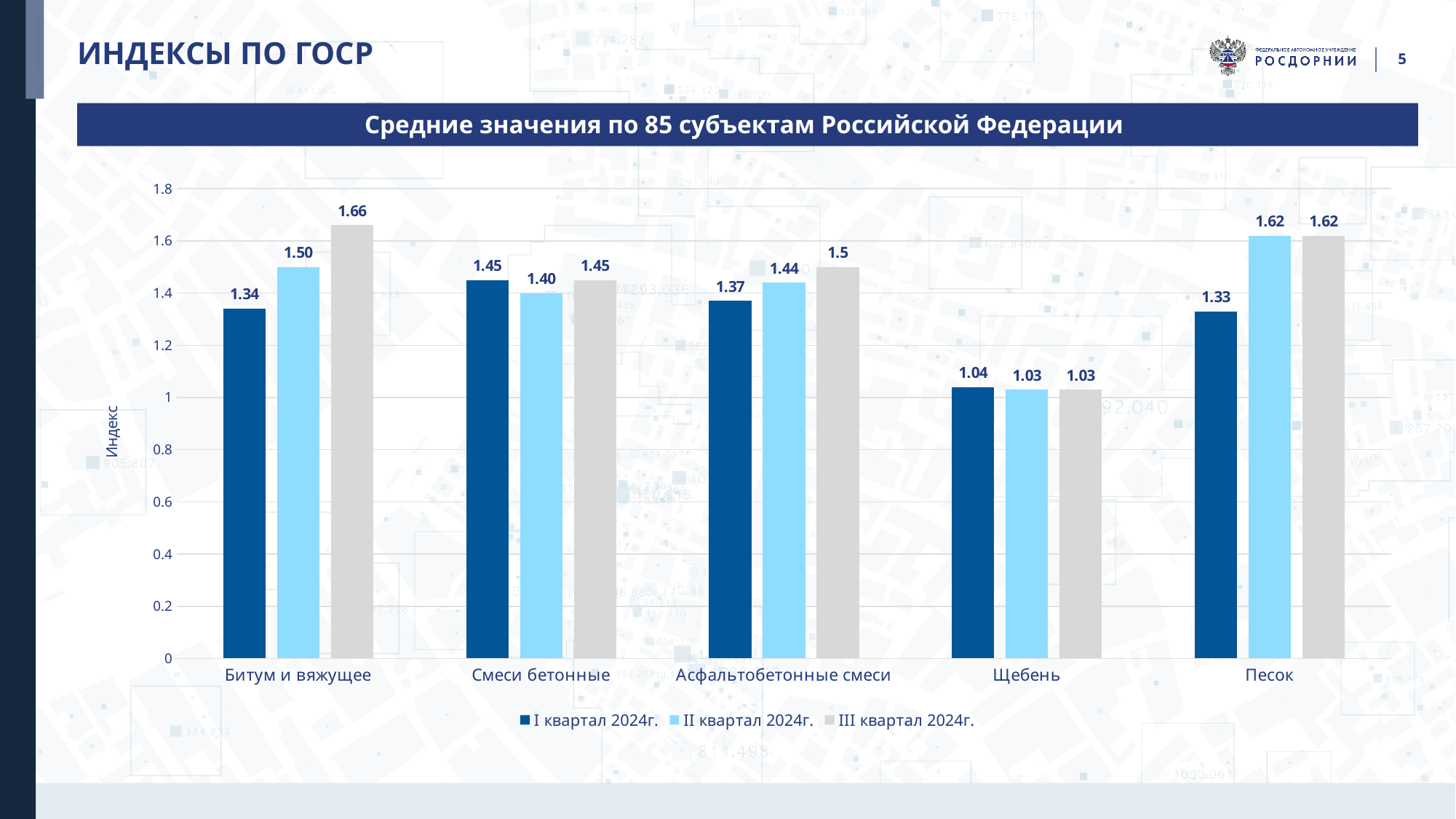
Which is larger: the II квартал 2024г. value for Песок or the II квартал 2024г. value for Смеси бетонные? Песок Which category has the lowest value in I квартал 2024г.? Щебень What is the difference between the III квартал 2024г. and I квартал 2024г. values for Битум и вяжущее? 0.32 What is the value for Щебень in I квартал 2024г.? 1.04 What is the value for Битум и вяжущее in III квартал 2024г.? 1.66 What kind of chart is shown on the slide? Bar chart Which category has the highest value in III квартал 2024г.? Битум и вяжущее How many categories are shown on the x axis? 5 Do the values for Песок rise or fall from I квартал 2024г. to II квартал 2024г.? Rise What is the value for Асфальтобетонные смеси in II квартал 2024г.? 1.44 How many series does the legend list? 3 What is the title of the chart? Средние значения по 85 субъектам Российской Федерации